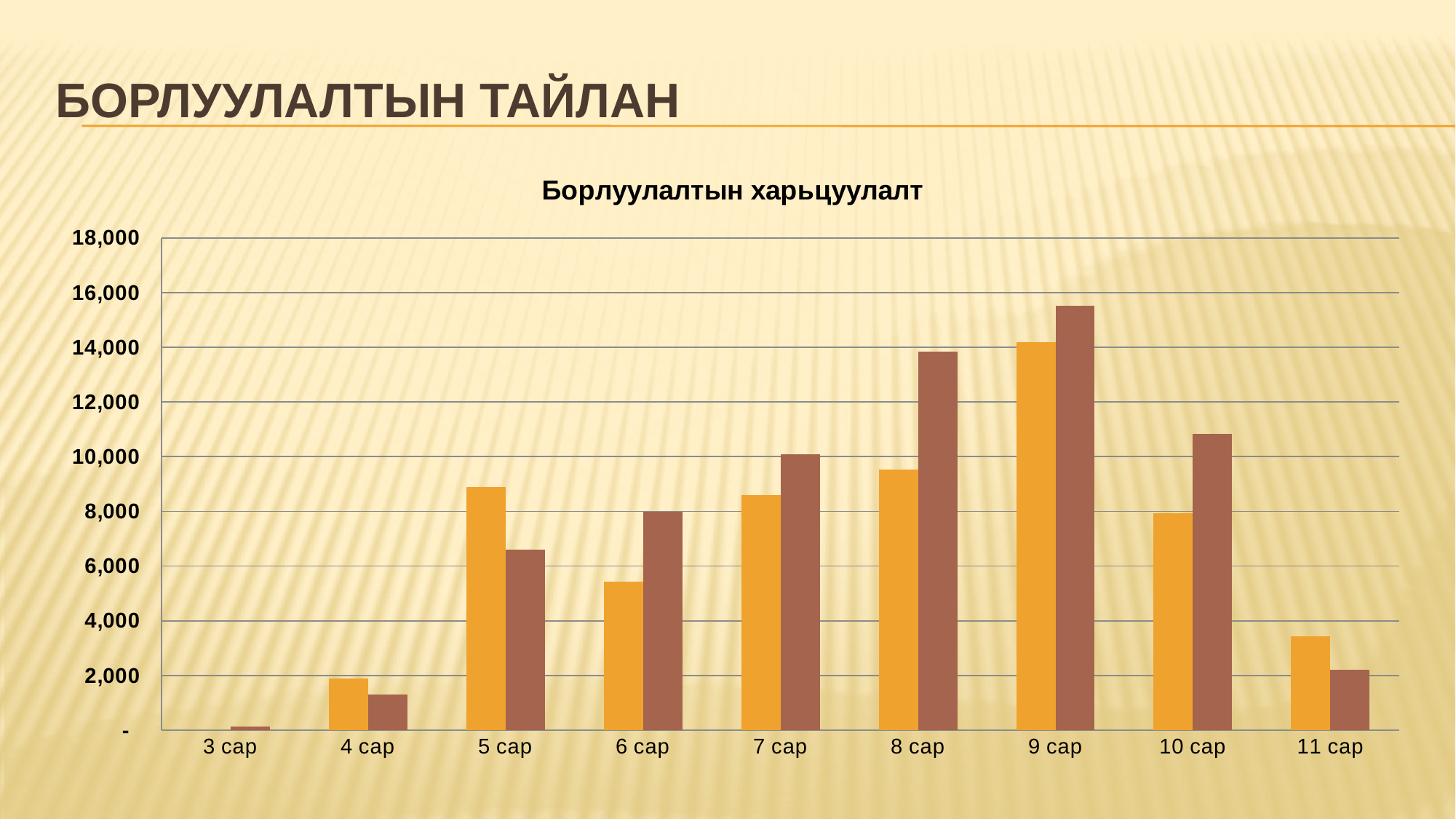
Is the brown bar for 8 сар greater or less than 12,000? greater What is the title of the chart? Борлуулалтын харьцуулалт For 8 сар, which bar is larger, the orange one or the brown one? brown How many bars are plotted for each category in the chart? 2 In which category is the brown bar the highest? 9 сар Is the orange bar for 6 сар greater or less than 6,000? less What kind of chart is shown on the slide? bar chart Is the brown bar for 9 сар greater or less than 14,000? greater In which category is the orange bar the highest? 9 сар For 5 сар, which bar is larger, the orange one or the brown one? orange In which category is the brown bar the lowest? 3 сар How many categories are shown on the x axis of the chart? 9